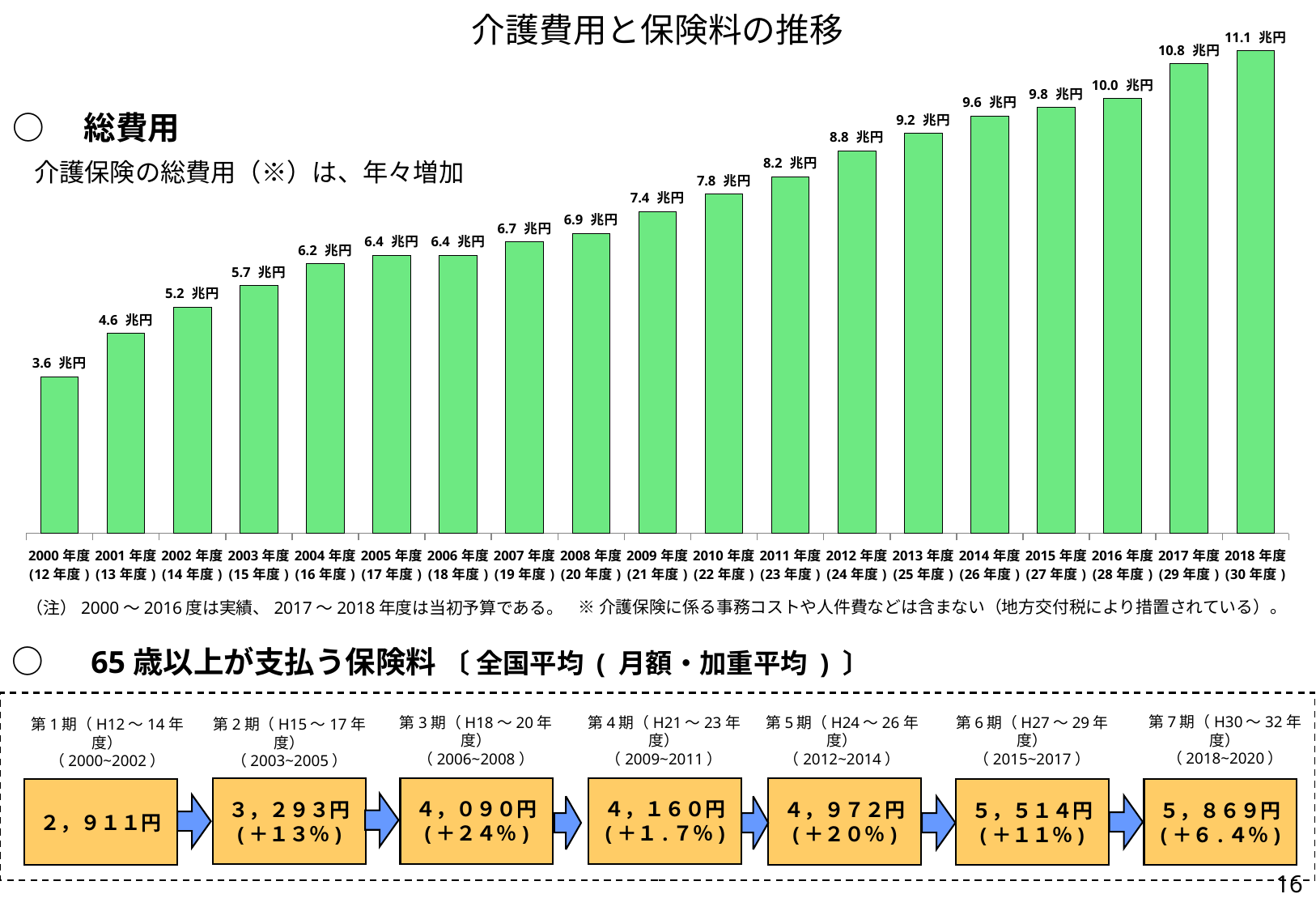
Do the values in the bar chart rise or fall from 2000年度 to 2018年度? Rise What is the difference between the values for 2017年度 and 2016年度? 0.8 兆円 Which is larger, the value for 2009年度 or the value for 2008年度? 2009年度 How many bars are shown in the bar chart? 19 Which year has the lowest value in the bar chart? 2000年度 What colour are the bars in the chart? Green What is the value for 2000年度 in the bar chart? 3.6 兆円 What is the value for 2018年度 in the bar chart? 11.1 兆円 What is the difference between the values for 2018年度 and 2000年度? 7.5 兆円 Which year has the highest value in the bar chart? 2018年度 What is the value for 2010年度 in the bar chart? 7.8 兆円 What kind of chart is shown at the top of the slide? Bar chart